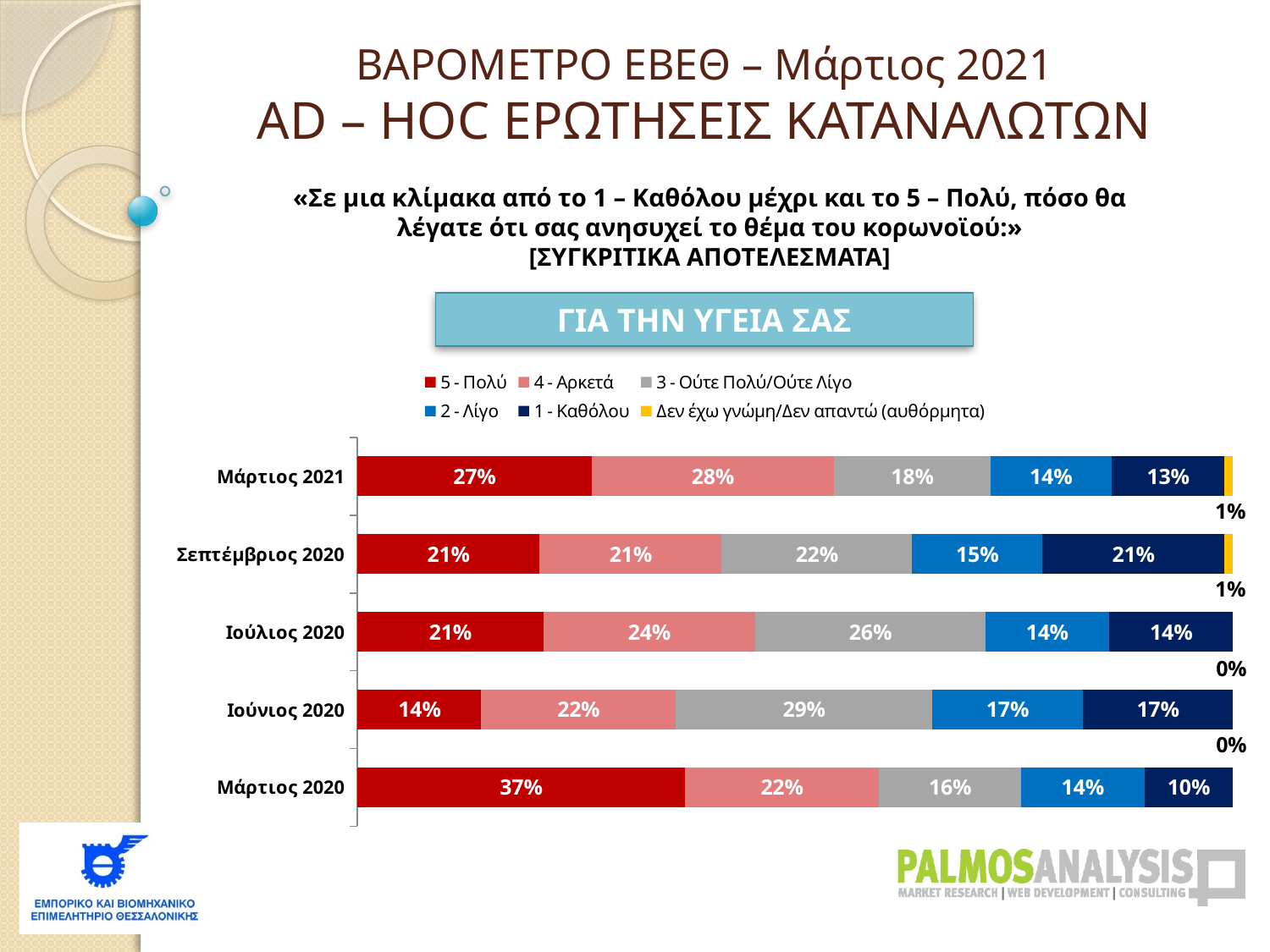
What is the value of '5 - Πολύ' for Μάρτιος 2021? 27% What is the value of 'Δεν έχω γνώμη/Δεν απαντώ (αυθόρμητα)' for Ιούλιος 2020? 0% Which is larger: the '4 - Αρκετά' value for Μάρτιος 2021 or for Ιούλιος 2020? Μάρτιος 2021 What is the value of '3 - Ούτε Πολύ/Ούτε Λίγο' for Ιούνιος 2020? 29% Which period has the highest value for '5 - Πολύ'? Μάρτιος 2020 What type of chart is shown on the slide? stacked bar chart What is the difference between the '5 - Πολύ' values for Μάρτιος 2020 and Μάρτιος 2021? 10% What is the title shown in the box above the chart? ΓΙΑ ΤΗΝ ΥΓΕΙΑ ΣΑΣ Which period has the lowest value for '5 - Πολύ'? Ιούνιος 2020 How many series does the legend list? 6 How many time periods (categories) are shown on the chart? 5 What is the value of '1 - Καθόλου' for Σεπτέμβριος 2020? 21%